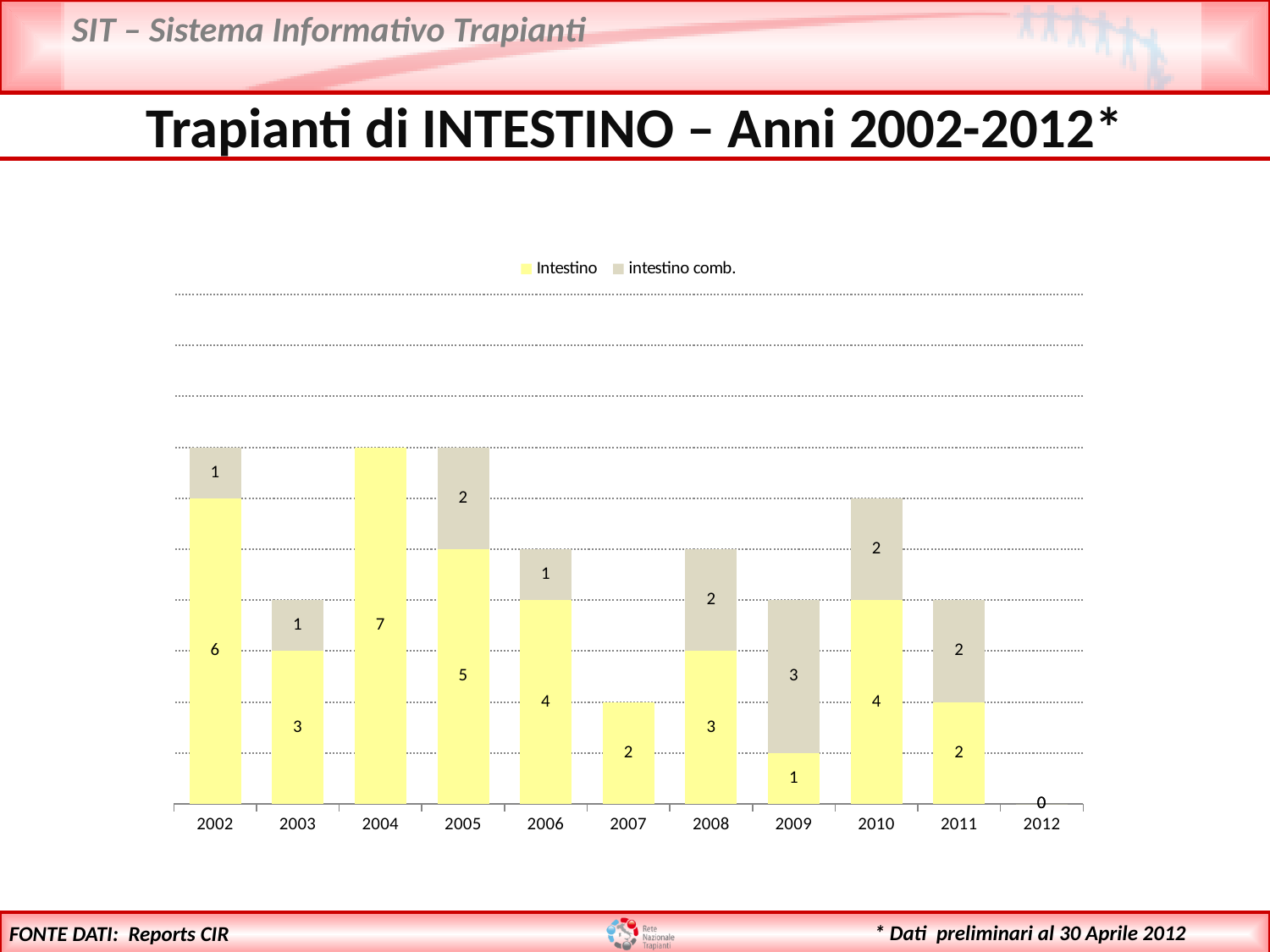
What is the value for Intestino in 2004? 7 What is the total of the stacked bar for 2005? 7 What is the value for Intestino in 2012? 0 Which is larger, the Intestino value for 2006 or for 2008? 2006 What type of chart is shown on the slide? stacked bar chart What is the value for intestino comb. in 2009? 3 What is the difference between the Intestino values for 2002 and 2003? 3 How many years are shown on the x axis? 11 How many series does the legend list? 2 Which year has the highest value for intestino comb.? 2009 What is the total of the stacked bar for 2010? 6 Which year has the highest value for Intestino? 2004